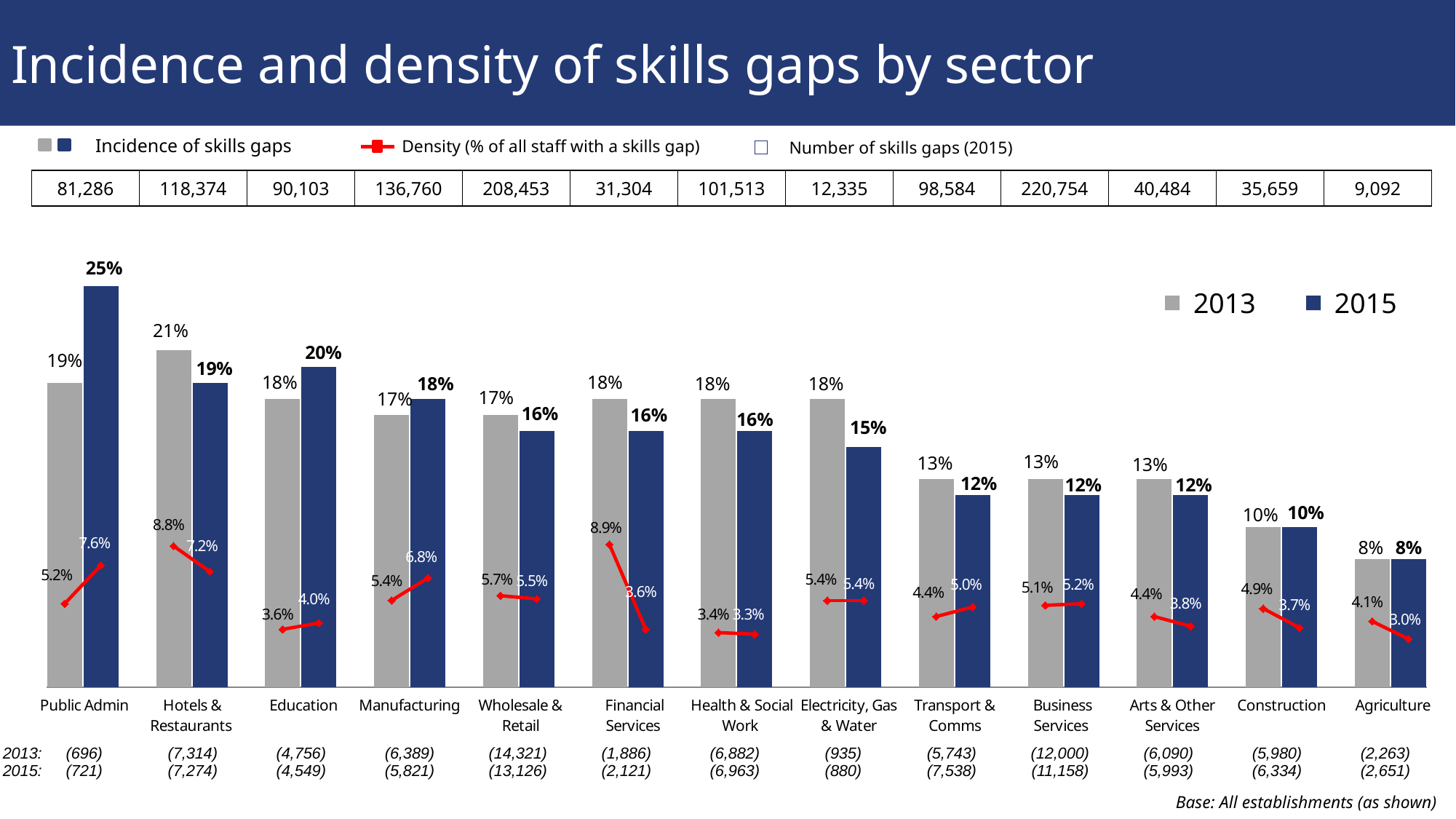
What is the 2015 density of skills gaps for Agriculture? 3.0% How many sectors are shown on the x axis of the chart? 13 What is the incidence of skills gaps for Public Admin in 2015? 25% Which is larger: the 2013 incidence of skills gaps for Hotels & Restaurants or for Education? Hotels & Restaurants What kind of chart is used to show the incidence of skills gaps? Bar chart Do the 2015 incidence values generally rise or fall moving from Public Admin on the left to Agriculture on the right? Fall Which sector has the lowest incidence of skills gaps in 2013? Agriculture What is the density of skills gaps for Financial Services in 2013? 8.9% What is the difference between the 2015 and 2013 incidence of skills gaps for Public Admin? 6 percentage points Which sector has the highest incidence of skills gaps in 2015? Public Admin How many series does the legend in the top right of the chart list? 2 What is the number of skills gaps (2015) shown for Business Services? 220,754